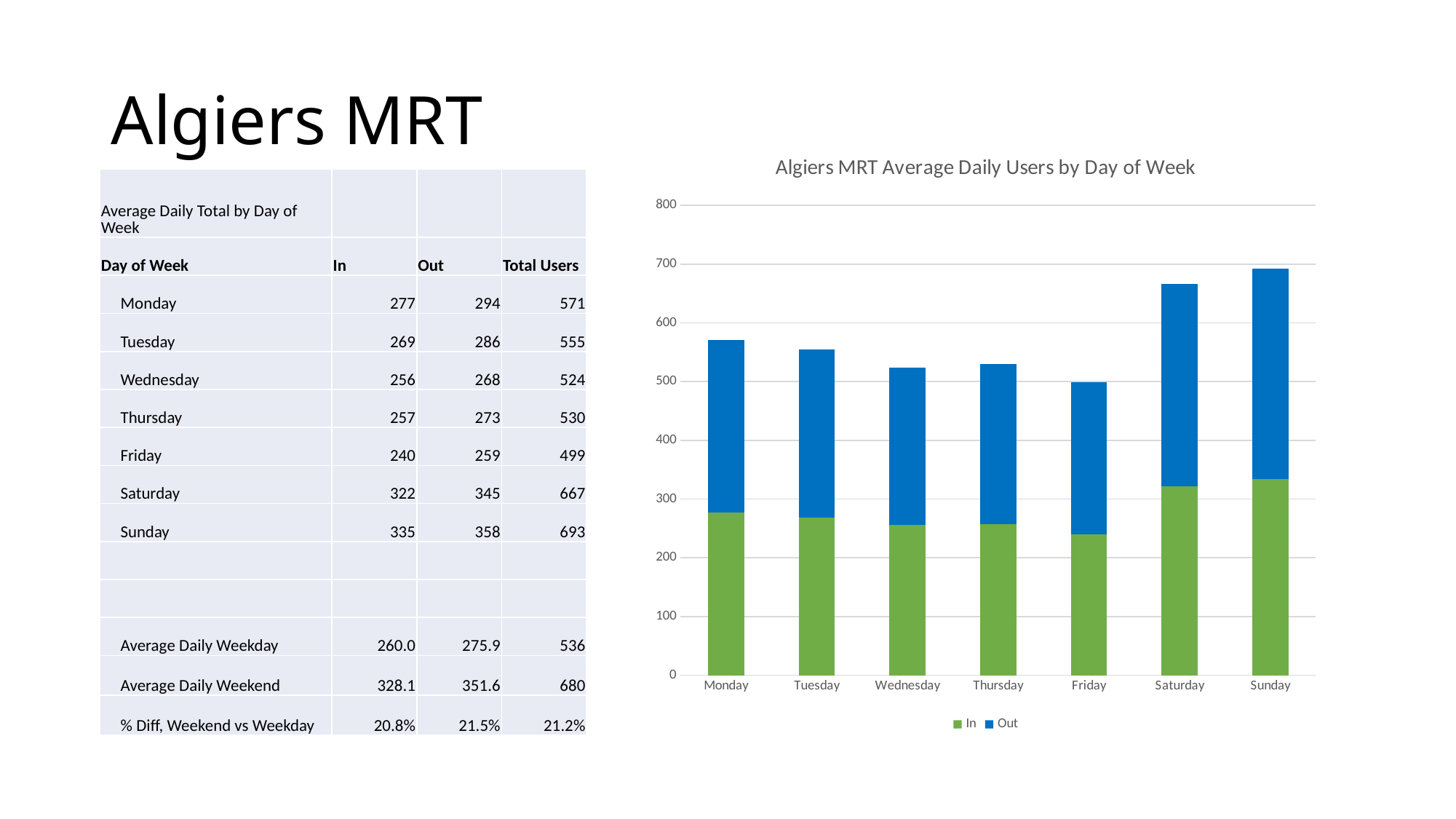
What kind of chart is shown on the slide? bar chart What is the title of the chart? Algiers MRT Average Daily Users by Day of Week How many series does the legend list in the chart? 2 What is the total of the stacked bar for Sunday, as printed in the table on the slide? 693 Is the stacked bar for Sunday taller or shorter than the bar for Monday? taller What is the difference between the Total Users for Saturday and Friday, using the values printed in the table? 168 What is the In value for Monday, as printed in the table on the slide? 277 Which day has the tallest stacked bar in the chart? Sunday Which day has the shortest stacked bar in the chart? Friday Is the total stacked bar for Saturday greater or less than 600? greater How many days of the week are plotted on the x axis of the chart? 7 Is the In value for Friday greater or less than 300? less